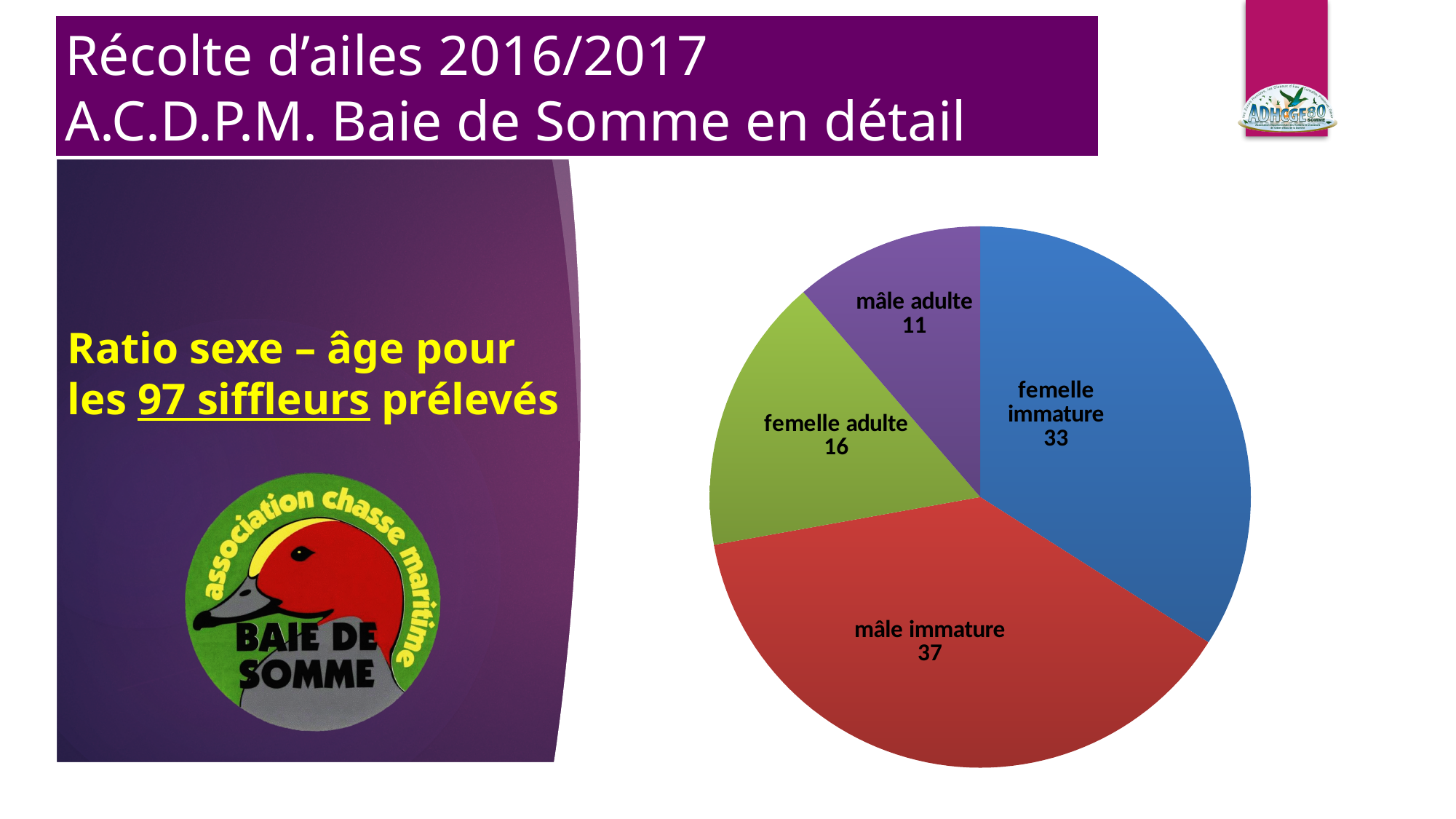
Which category has the smallest slice? mâle adulte What is the difference between femelle adulte and mâle adulte? 5 What kind of chart is shown on the slide? pie chart What is the value for femelle adulte? 16 What is the difference between mâle immature and femelle immature? 4 How many slices does the pie chart have? 4 What is the value for femelle immature? 33 Which is larger, femelle adulte or mâle adulte? femelle adulte What colour is the mâle immature slice? red Which category has the largest slice? mâle immature What is the value for mâle immature? 37 What is the value for mâle adulte? 11